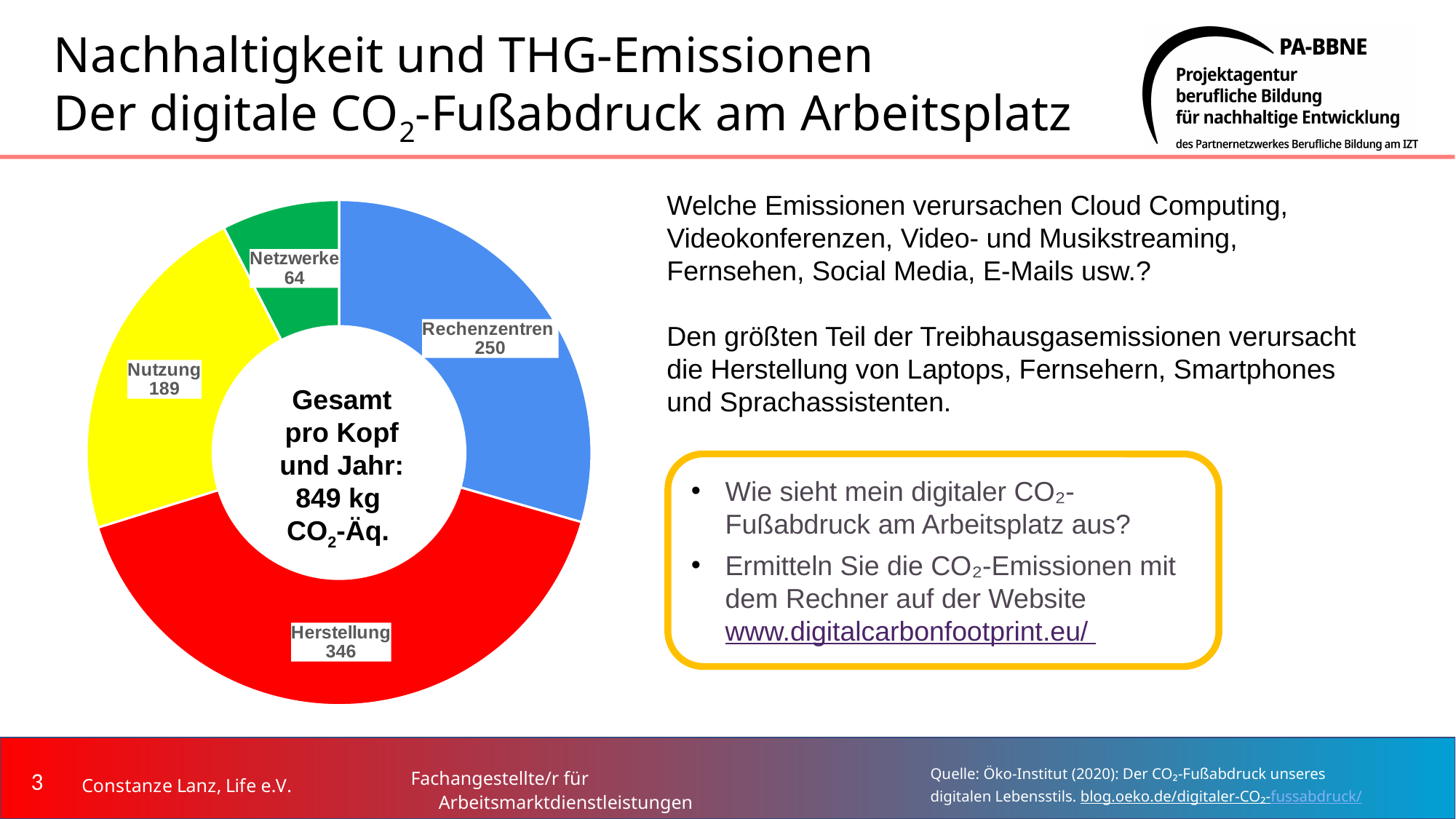
What total per person and year is stated in the centre of the chart? 849 kg CO2-Äq. What value is shown for Herstellung in the chart? 346 How many categories are shown in the chart? 4 What value is shown for Netzwerke in the chart? 64 Which category has the largest slice in the chart? Herstellung What is the difference between the values for Herstellung and Rechenzentren? 96 Which is larger, the value for Nutzung or the value for Rechenzentren? Rechenzentren What kind of chart is shown on the slide? doughnut chart What value is shown for Nutzung in the chart? 189 What value is shown for Rechenzentren in the chart? 250 Which category has the smallest slice in the chart? Netzwerke What colour is the Herstellung slice in the chart? red